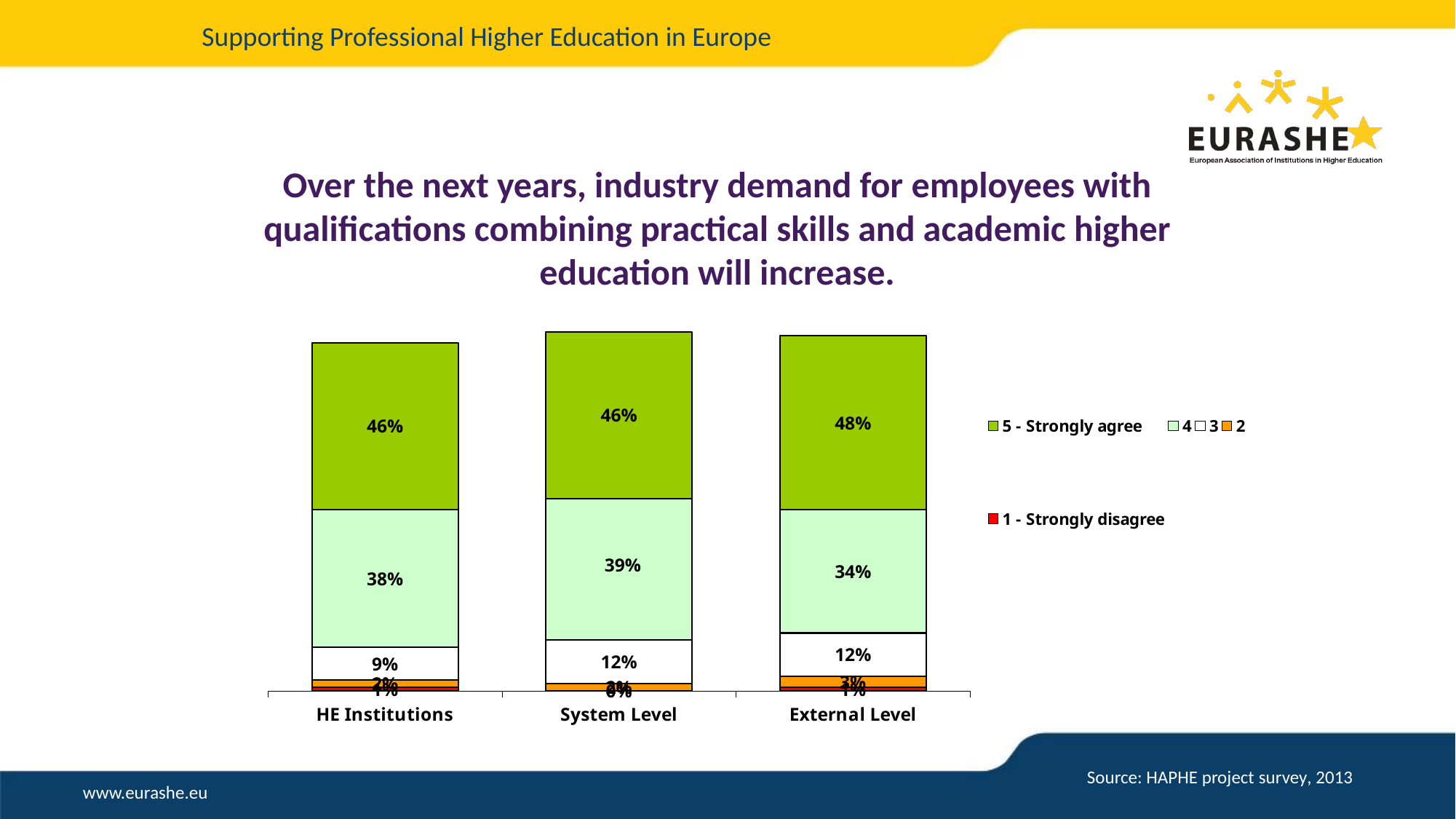
What is the value of the '3' segment for HE Institutions? 9% Which is larger: the '4' segment for HE Institutions or for System Level? System Level How many categories are shown on the x axis of the chart? 3 Which category has the lowest value for the '4' segment? External Level What is the value of the '5 - Strongly agree' segment for External Level? 48% What is the value of the '4' segment for System Level? 39% What is the value of the '5 - Strongly agree' segment for HE Institutions? 46% Which category has the highest '5 - Strongly agree' value? External Level What kind of chart is shown on the slide? Stacked bar chart What is the difference between the '5 - Strongly agree' values for External Level and HE Institutions? 2% How many series does the chart's legend list? 5 What is the value of the '3' segment for External Level? 12%